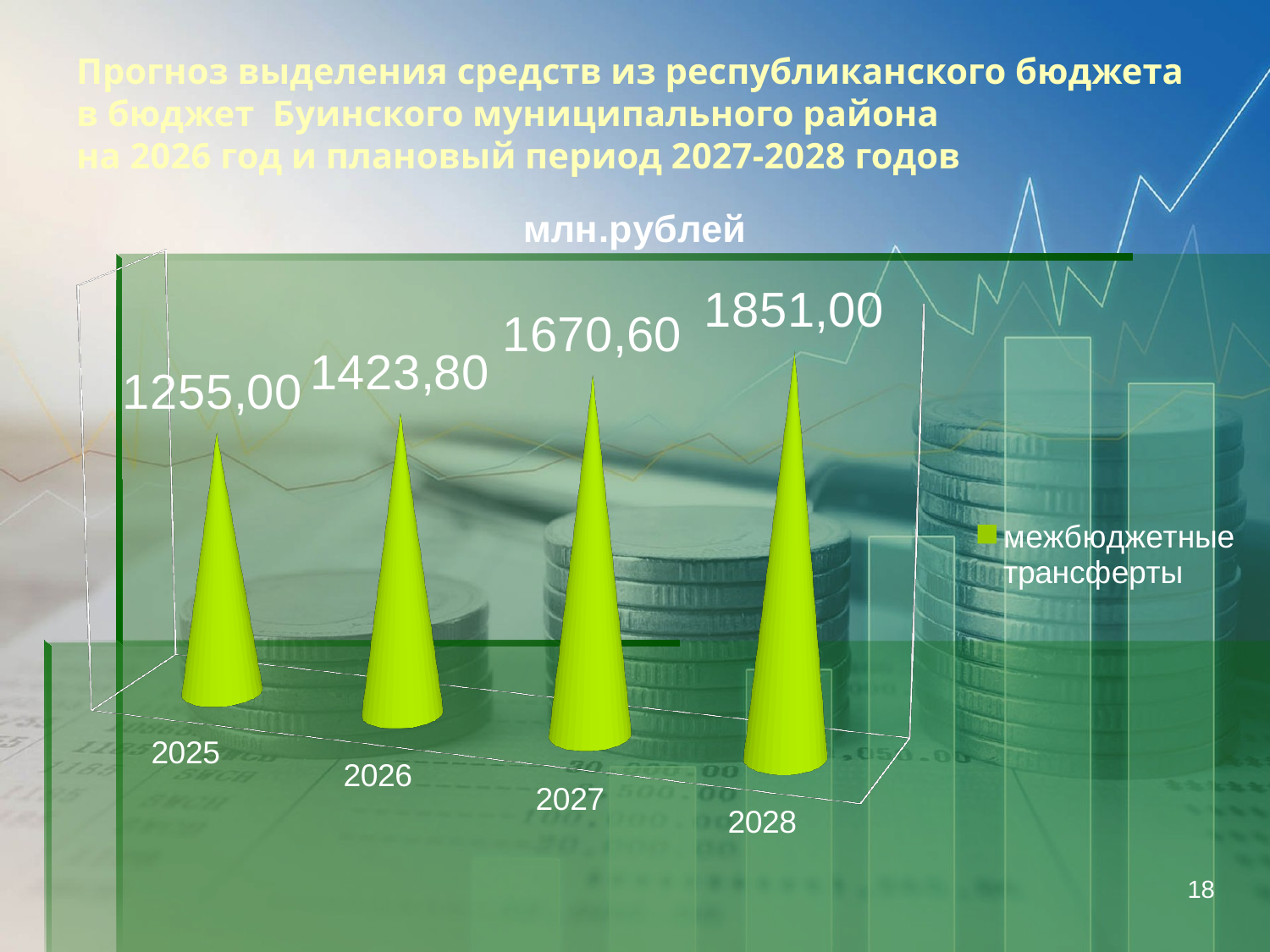
Do the values rise or fall from 2025 to 2028? rise What is the value for 2028? 1851,00 What is the value for 2027? 1670,60 What is the value for 2025? 1255,00 What is the value for 2026? 1423,80 Which is larger, the value for 2026 or the value for 2027? 2027 Which year has the highest value? 2028 What is the difference between the values for 2026 and 2025? 168,80 What series name does the legend show? межбюджетные трансферты How many years are shown on the x axis? 4 What is the difference between the values for 2028 and 2027? 180,40 Which year has the lowest value? 2025